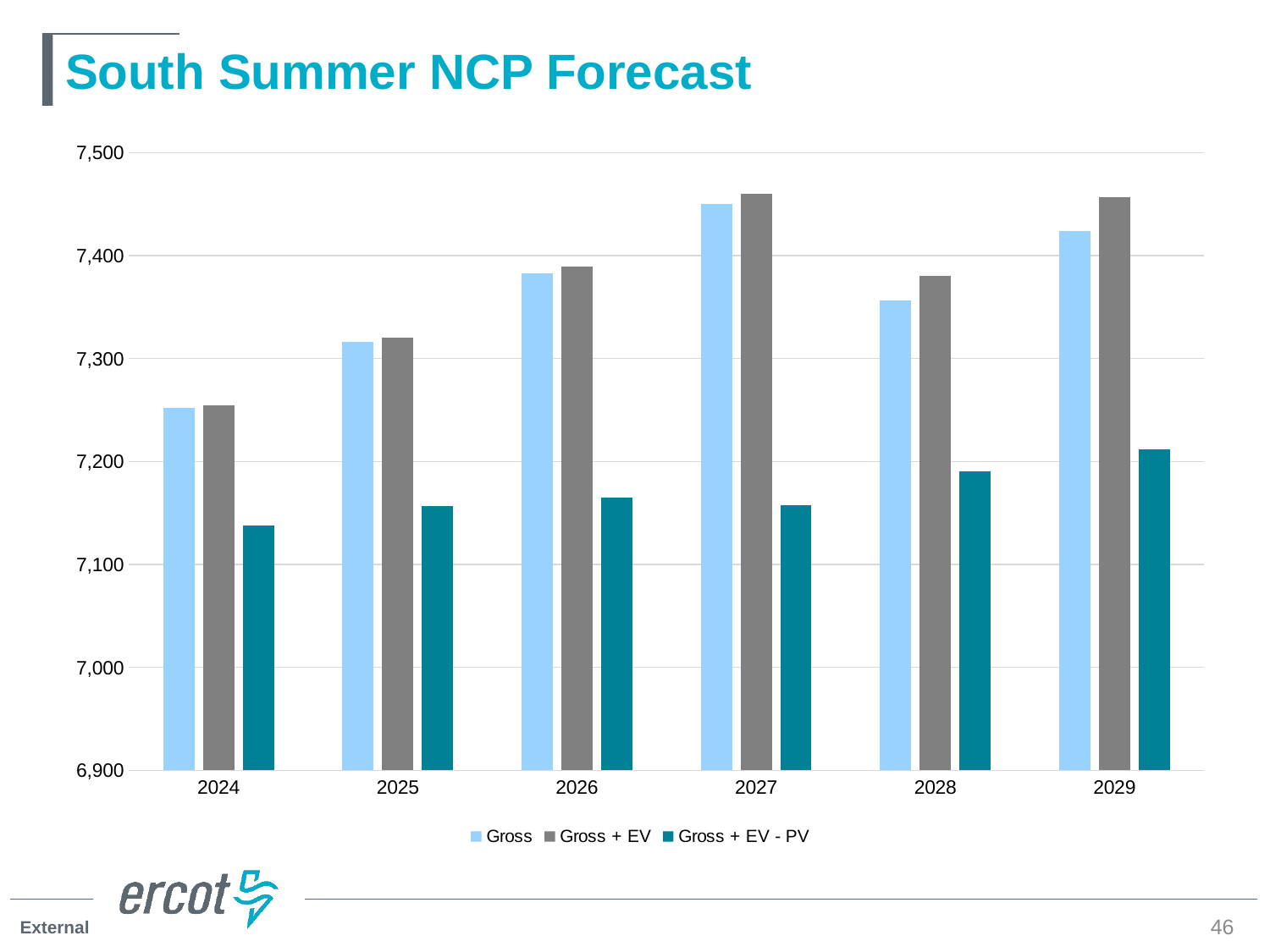
Is the Gross value for 2024 greater or less than 7,300? less Which is larger, the Gross value for 2027 or the Gross value for 2028? 2027 How many years are shown on the x axis? 6 Which year has the highest Gross + EV - PV value? 2029 Is the Gross + EV value for 2027 greater or less than 7,400? greater Which year has the highest Gross value? 2027 What kind of chart is shown on the slide? bar chart Do the Gross values rise or fall from 2024 to 2027? rise Which year has the lowest Gross + EV - PV value? 2024 Is the Gross + EV - PV value for 2027 greater or less than 7,200? less Which year has the lowest Gross value? 2024 How many series does the legend list? 3